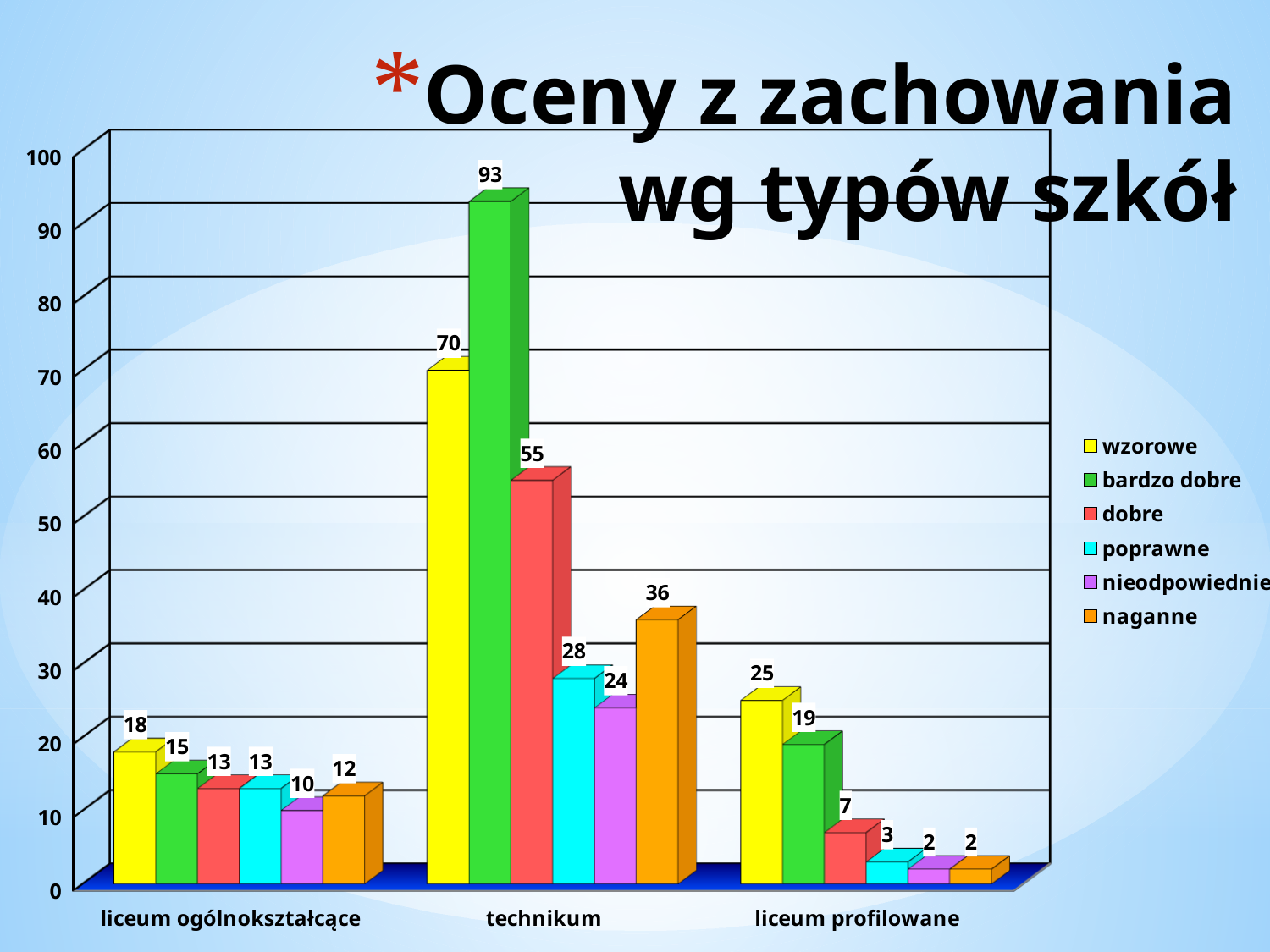
Which series has the lowest value in the technikum category? nieodpowiednie Which is larger: 'naganne' for technikum or 'poprawne' for technikum? naganne for technikum How many series does the legend list? 6 What is the value for 'dobre' in the liceum profilowane category? 7 Is the value for 'dobre' in the technikum category greater or less than 50? greater What kind of chart is shown on the slide? bar chart What is the value for 'naganne' in the liceum ogólnokształcące category? 12 How many school types (categories) are shown on the x axis? 3 What is the title of the chart? Oceny z zachowania wg typów szkół What is the difference between the 'bardzo dobre' and 'wzorowe' values in the technikum category? 23 Which category has the highest value for the 'wzorowe' series? technikum What is the value for 'bardzo dobre' in the technikum category? 93